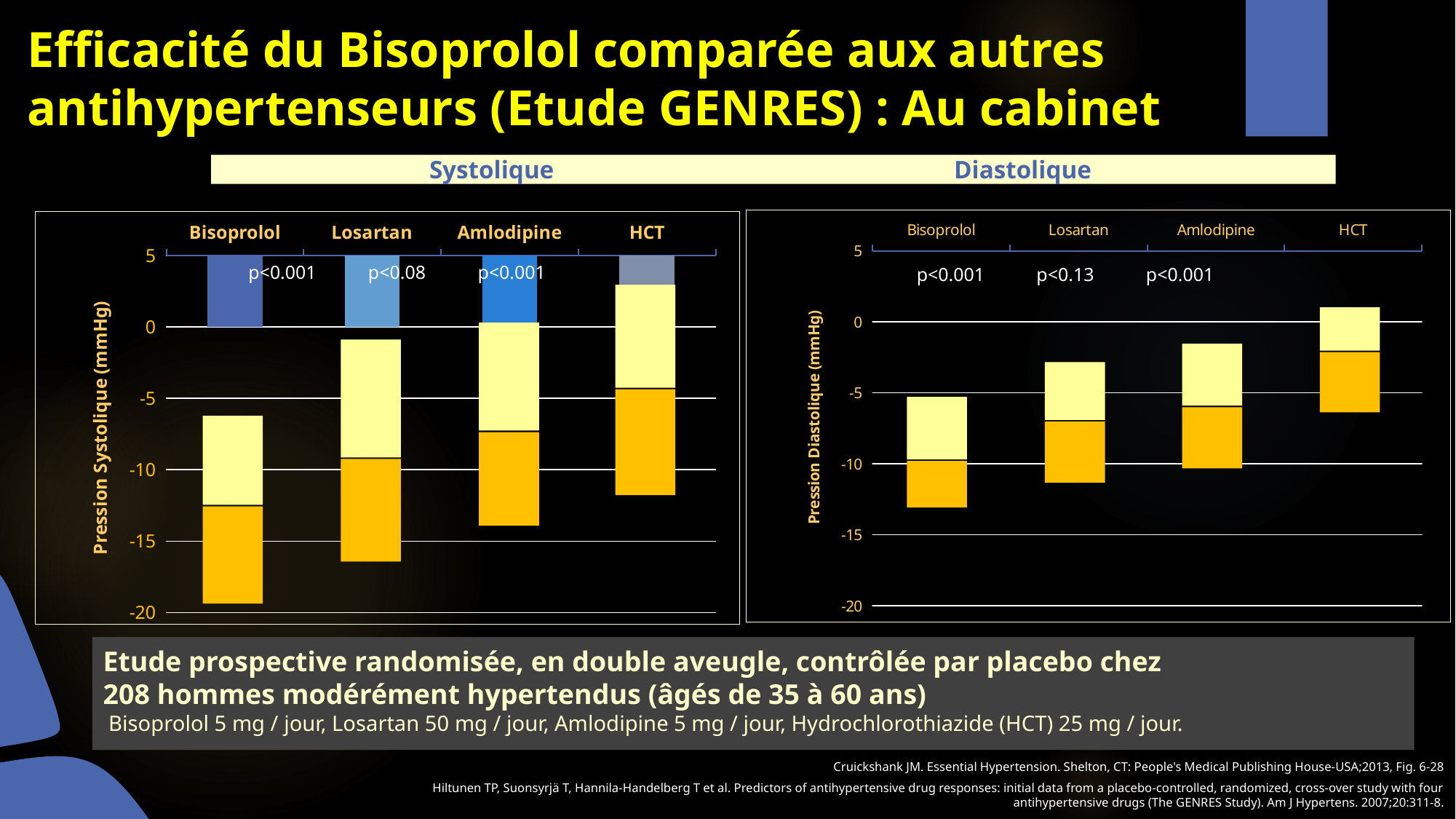
In the Systolique chart, is the lowest point of the Bisoprolol bar greater or less than -15? less How many charts are shown on the slide? 2 In the Systolique chart, which drug's bar extends lowest on the axis? Bisoprolol In the Diastolique chart, is the lowest point of the HCT bar greater or less than -10? greater In the Systolique chart, what p-value is printed for Losartan? p<0.08 In the Diastolique chart, is the lowest point of the Bisoprolol bar greater or less than -10? less In the Diastolique chart, which drug's bar extends lowest on the axis? Bisoprolol In the Diastolique chart, what p-value is printed for Losartan? p<0.13 In the Systolique chart, how many drug categories are plotted? 4 What is the y-axis title of the Systolique chart? Pression Systolique (mmHg) What kind of chart is the Diastolique chart? Bar chart